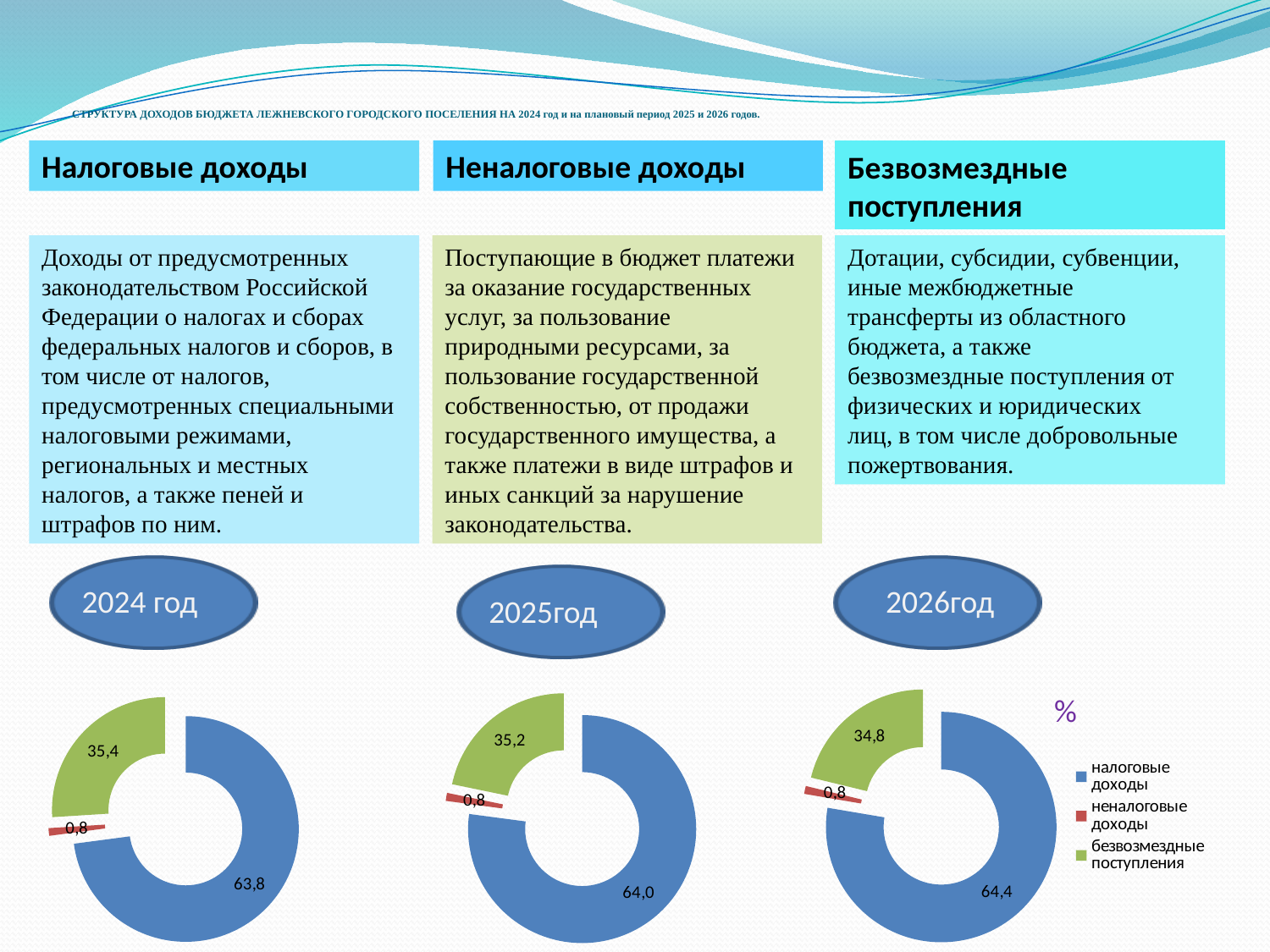
In the 2026год chart, what is the difference between налоговые доходы and безвозмездные поступления? 29,6 What type of chart is used for the 2025год data? doughnut chart In the 2025год chart, which category has the smallest share? неналоговые доходы In the 2026год chart, what is the value for неналоговые доходы? 0,8 How many entries does the legend next to the 2026год chart list? 3 In the 2026год chart, what is the value for налоговые доходы? 64,4 Which colour represents безвозмездные поступления in the charts? green Which is larger: налоговые доходы in the 2024 год chart or налоговые доходы in the 2026год chart? 2026год How many categories does each doughnut chart show? 3 In the 2024 год chart, which category has the largest share? налоговые доходы In the 2024 год chart, what is the value for налоговые доходы? 63,8 In the 2025год chart, what is the value for безвозмездные поступления? 35,2